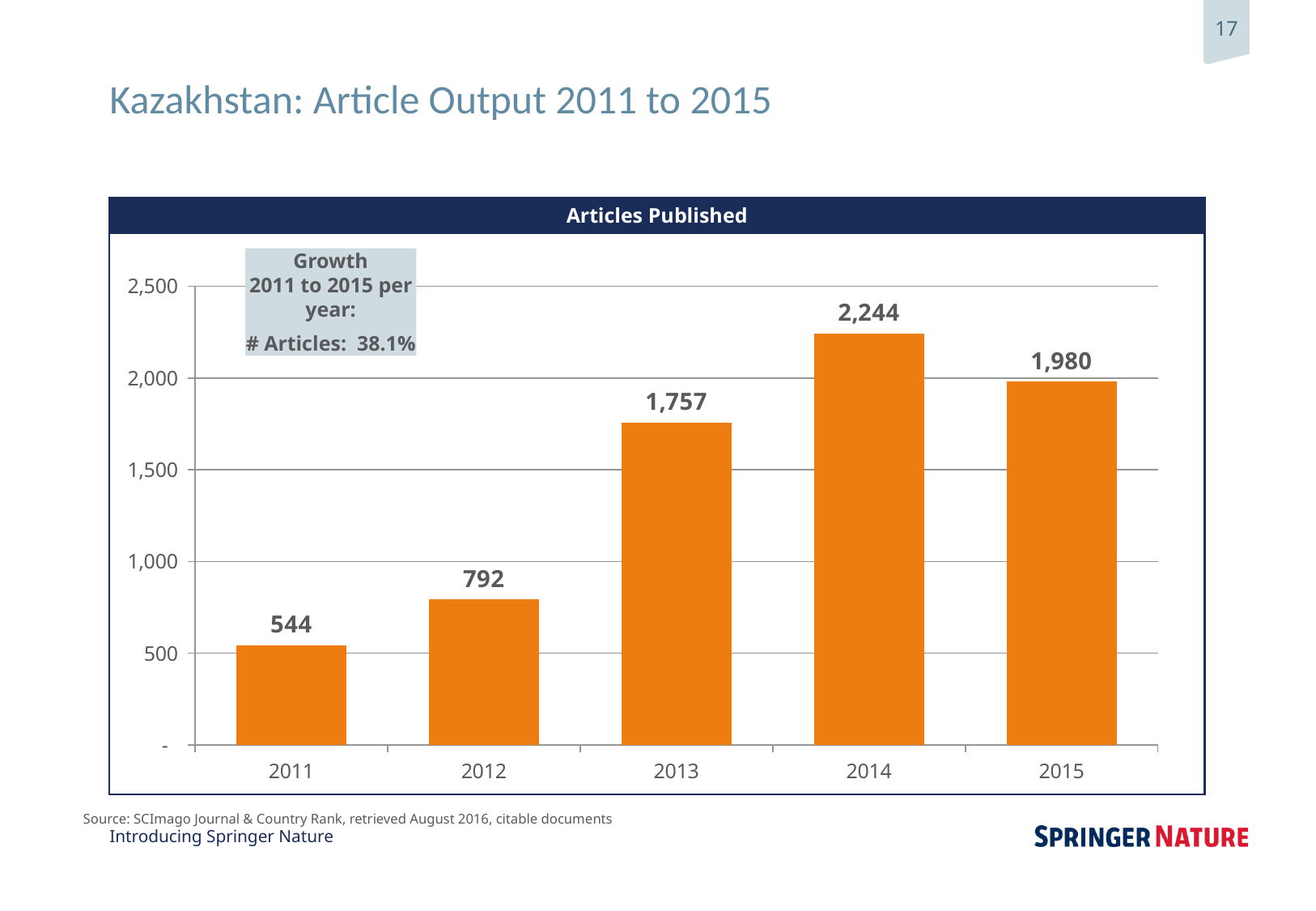
How many more articles were published in 2012 than in 2011? 248 How many articles were published in 2013? 1,757 Is the value for 2012 greater or less than 1,000? less Did the number of articles published rise or fall from 2014 to 2015? fall Which year had more articles published, 2013 or 2015? 2015 Which year has the highest number of articles published? 2014 How many years are shown on the x axis of the chart? 5 What is the difference between the articles published in 2014 and 2015? 264 What is the value for 2011 in the Articles Published chart? 544 What annual growth rate in number of articles from 2011 to 2015 is stated in the chart's text box? 38.1% What kind of chart is shown on the slide? bar chart Which year has the lowest number of articles published? 2011